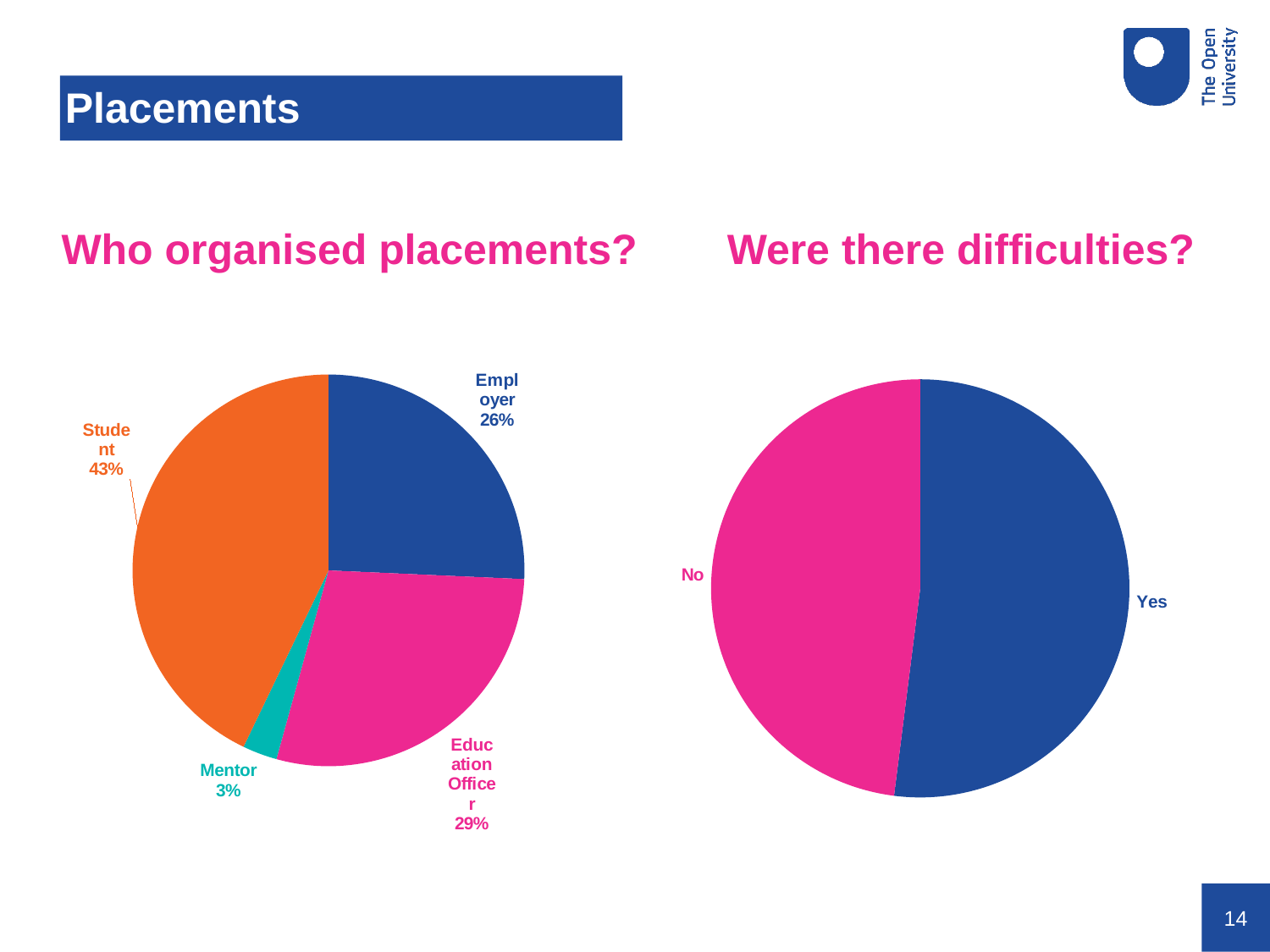
In the 'Who organised placements?' chart, how many percentage points larger is the Student share than the Employer share? 17 In the 'Who organised placements?' chart, which category has the smallest share? Mentor How many categories are shown in the 'Were there difficulties?' chart? 2 What type of chart is used for 'Were there difficulties?'? Pie chart In the 'Who organised placements?' chart, what percentage of placements were organised by the education officer? 29% In the 'Who organised placements?' chart, what percentage of placements were organised by a mentor? 3% In the 'Who organised placements?' chart, what percentage of placements were organised by the student? 43% In the 'Who organised placements?' chart, which is larger: the Education Officer share or the Employer share? Education Officer In the 'Who organised placements?' chart, what percentage of placements were organised by the employer? 26% In the 'Were there difficulties?' chart, what colour is the 'No' slice? Pink In the 'Who organised placements?' chart, which category has the largest share? Student How many categories are shown in the 'Who organised placements?' chart? 4